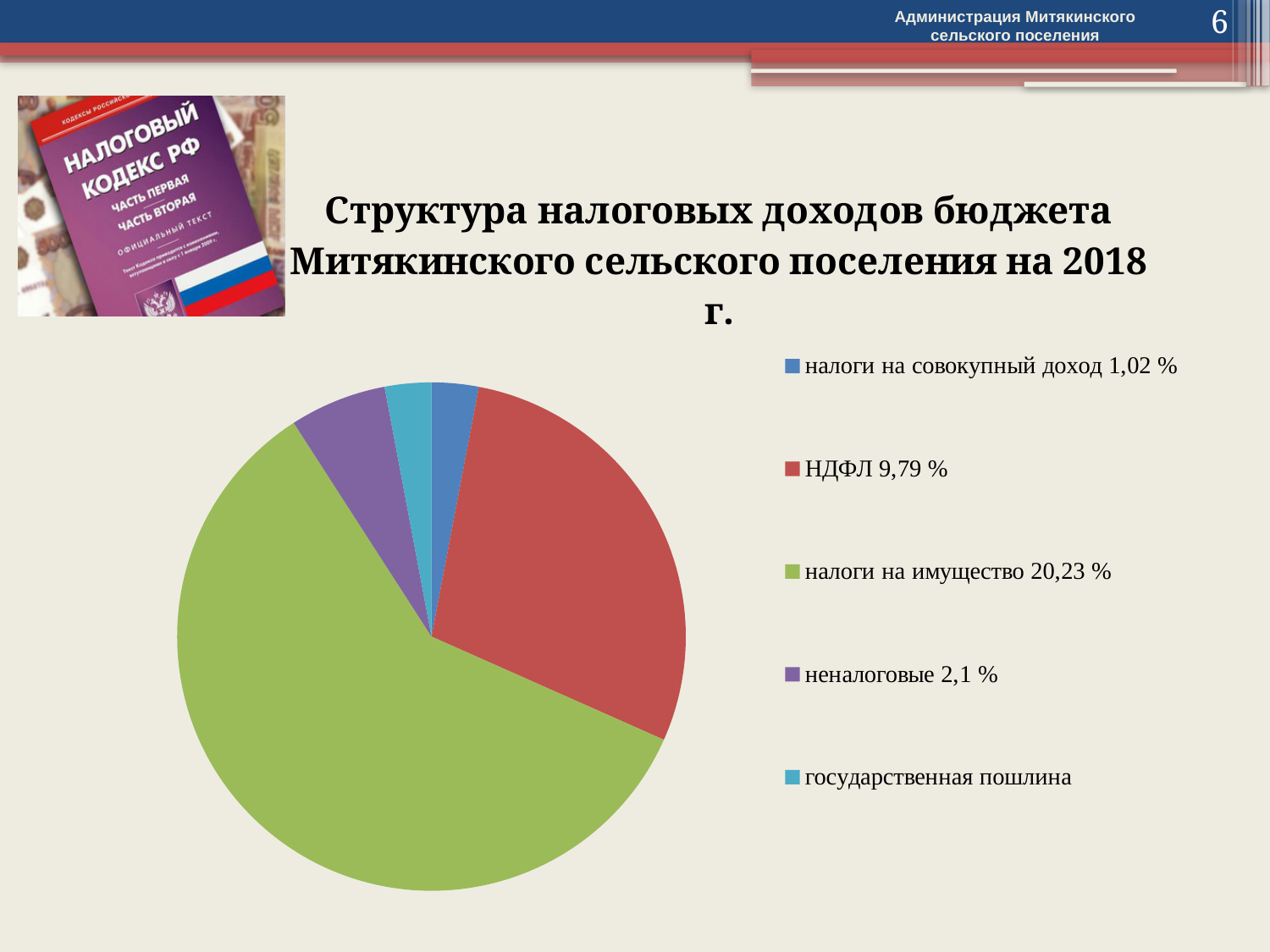
What colour is the slice for налоги на имущество? green What is the title of the chart? Структура налоговых доходов бюджета Митякинского сельского поселения на 2018 г. What kind of chart is shown on the slide? pie chart What value is given in the legend for налоги на совокупный доход? 1,02 % What is the difference between the values for налоги на имущество and НДФЛ? 10,44 % How many slices does the pie chart have? 5 What value is given in the legend for неналоговые? 2,1 % Which is larger, НДФЛ or неналоговые? НДФЛ What value is given in the legend for налоги на имущество? 20,23 % Which category has the largest slice of the pie? налоги на имущество What is the difference between the values for НДФЛ and налоги на совокупный доход? 8,77 % What value is given in the legend for НДФЛ? 9,79 %